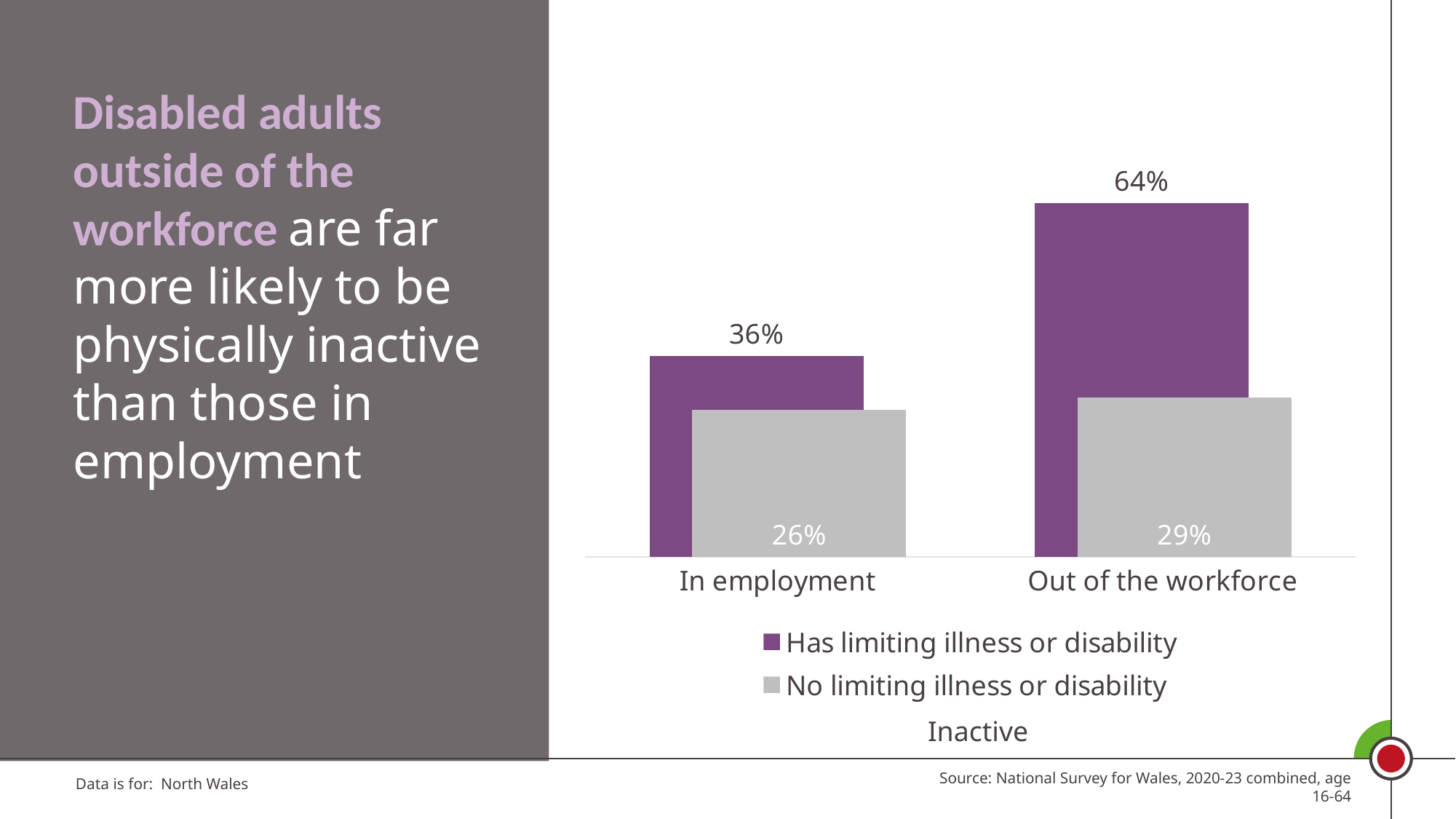
What percentage of people in employment with a limiting illness or disability are inactive? 36% Which bar on the chart has the highest value? Has limiting illness or disability, Out of the workforce What kind of chart is shown on the slide? Bar chart What is the value for 'No limiting illness or disability' in the 'Out of the workforce' category? 29% How many categories are shown on the x axis of the chart? 2 How many series does the chart's legend list? 2 Which bar on the chart has the lowest value? No limiting illness or disability, In employment What is the value for 'No limiting illness or disability' in the 'In employment' category? 26% What is the difference between the 'Has limiting illness or disability' values for 'Out of the workforce' and 'In employment'? 28% In the 'Out of the workforce' category, what is the difference between the 'Has limiting illness or disability' and 'No limiting illness or disability' values? 35% Which is larger: the 'Has limiting illness or disability' value for 'In employment' or the 'No limiting illness or disability' value for 'Out of the workforce'? Has limiting illness or disability, In employment What percentage of people out of the workforce with a limiting illness or disability are inactive? 64%